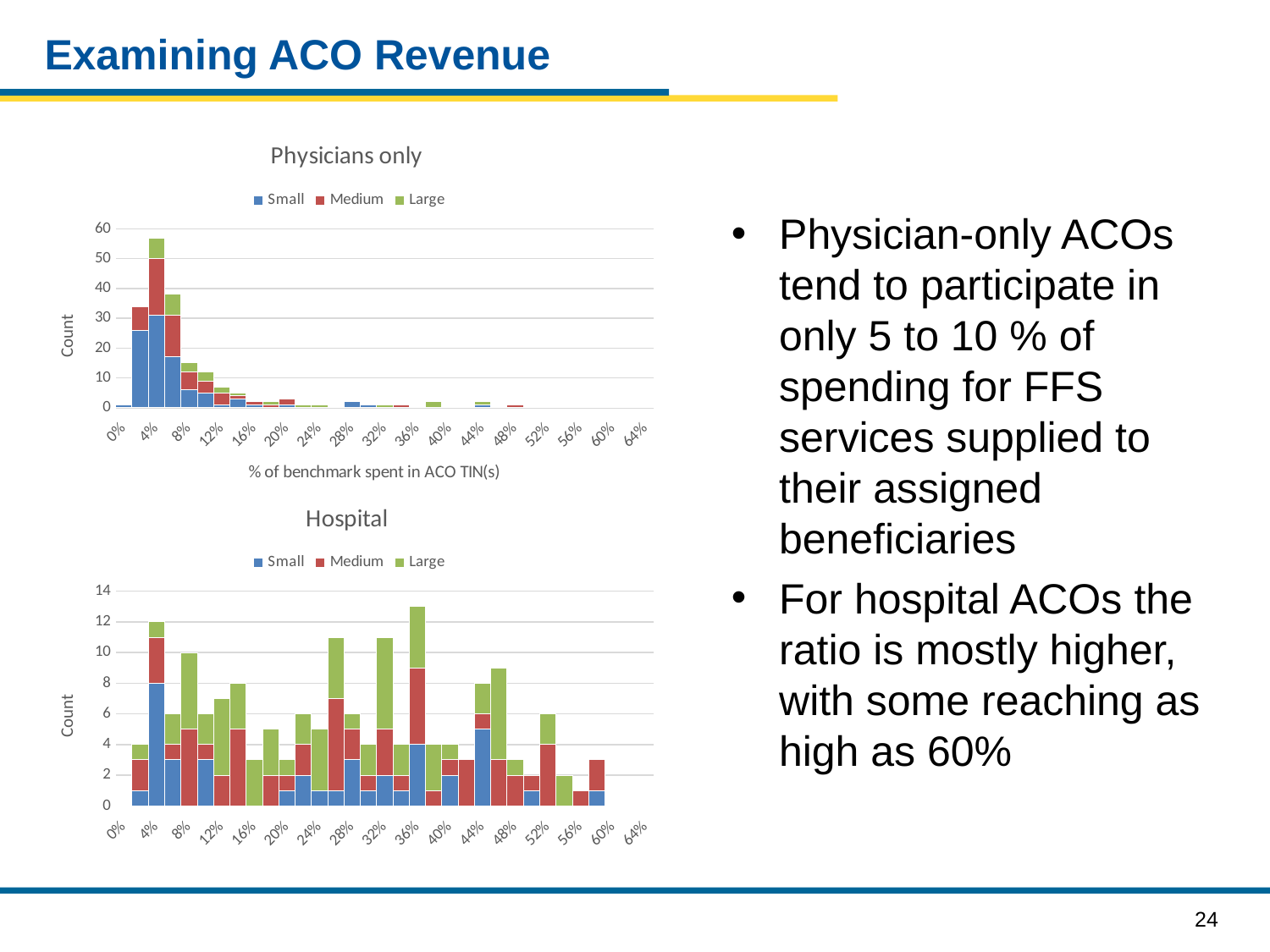
What are the legend entries of the "Physicians only" chart? Small, Medium, Large In the "Physicians only" chart, do the total counts generally rise or fall as the x-axis moves from 4% toward 64%? fall In the "Hospital" chart, is the total count at the 36% bin greater or less than 10? greater What is the x-axis title of the "Physicians only" chart? % of benchmark spent in ACO TIN(s) What is the highest value shown on the y-axis of the "Hospital" chart? 14 What kind of chart is the "Physicians only" chart? Stacked bar chart In the "Physicians only" chart, which x-axis bin has the tallest stacked bar? 4% How many series does the legend of the "Hospital" chart list? 3 In the "Hospital" chart, which is larger, the total count at the 4% bin or the total count at the 16% bin? 4% In the "Physicians only" chart, is the total count for the tallest bar greater or less than 50? greater In the "Hospital" chart, is the total count at the 0% bin greater or less than 6? less